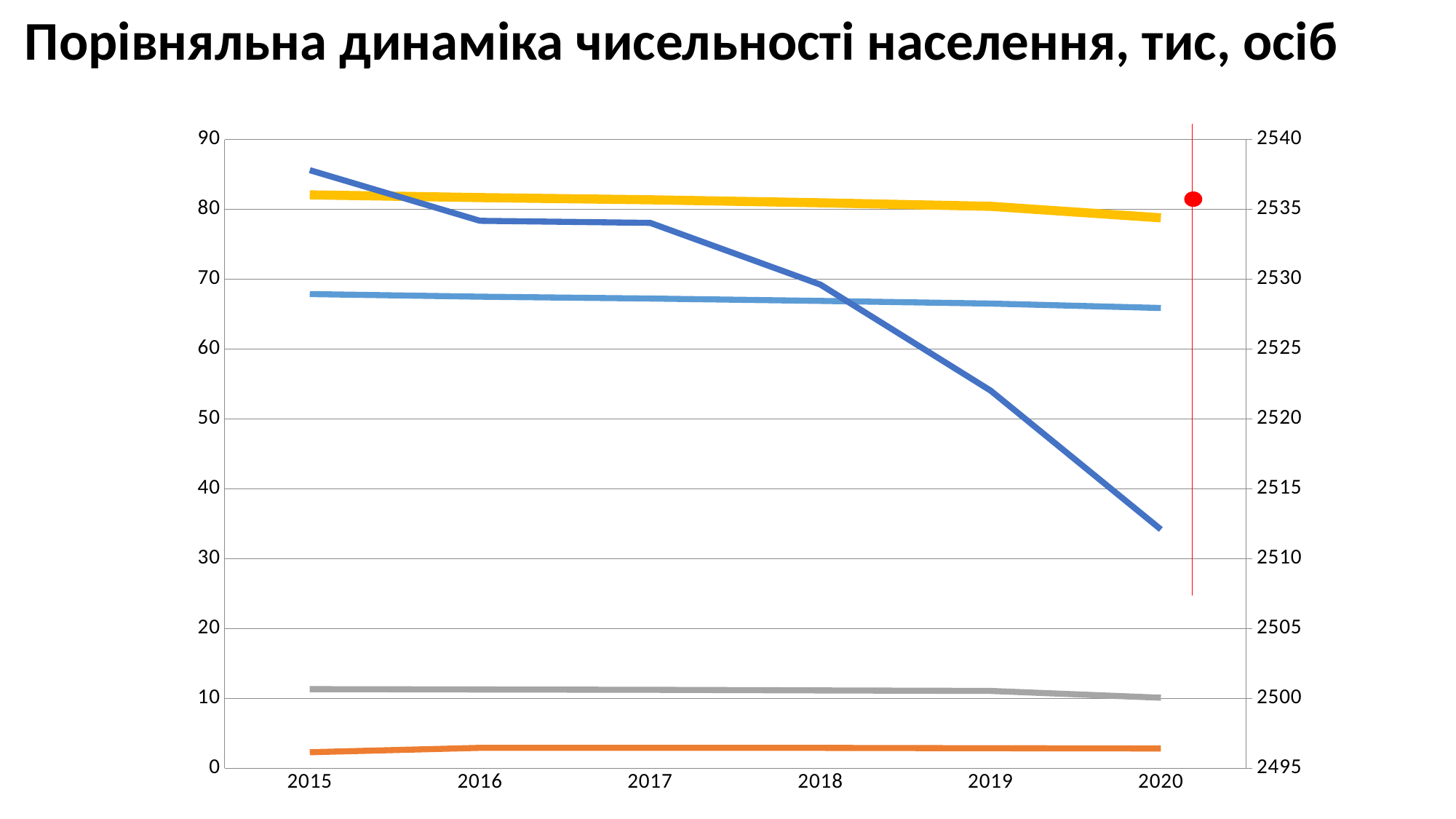
Is the value of the dark blue line in 2020 greater or less than 40 on the left axis? less Does the dark blue line rise or fall from 2015 to 2020? fall In 2019, which line is higher on the chart: the dark blue line or the light blue line? the light blue line Is the value of the gray line in 2018 greater or less than 20 on the left axis? less How many years are shown on the x axis of the chart? 6 Is the value of the yellow line in 2017 greater or less than 70 on the left axis? greater What is the title of the chart? Порівняльна динаміка чисельності населення, тис, осіб What kind of chart is shown on the slide? line chart What is the last year shown on the x axis? 2020 What is the highest tick value on the left y axis? 90 What is the first year shown on the x axis? 2015